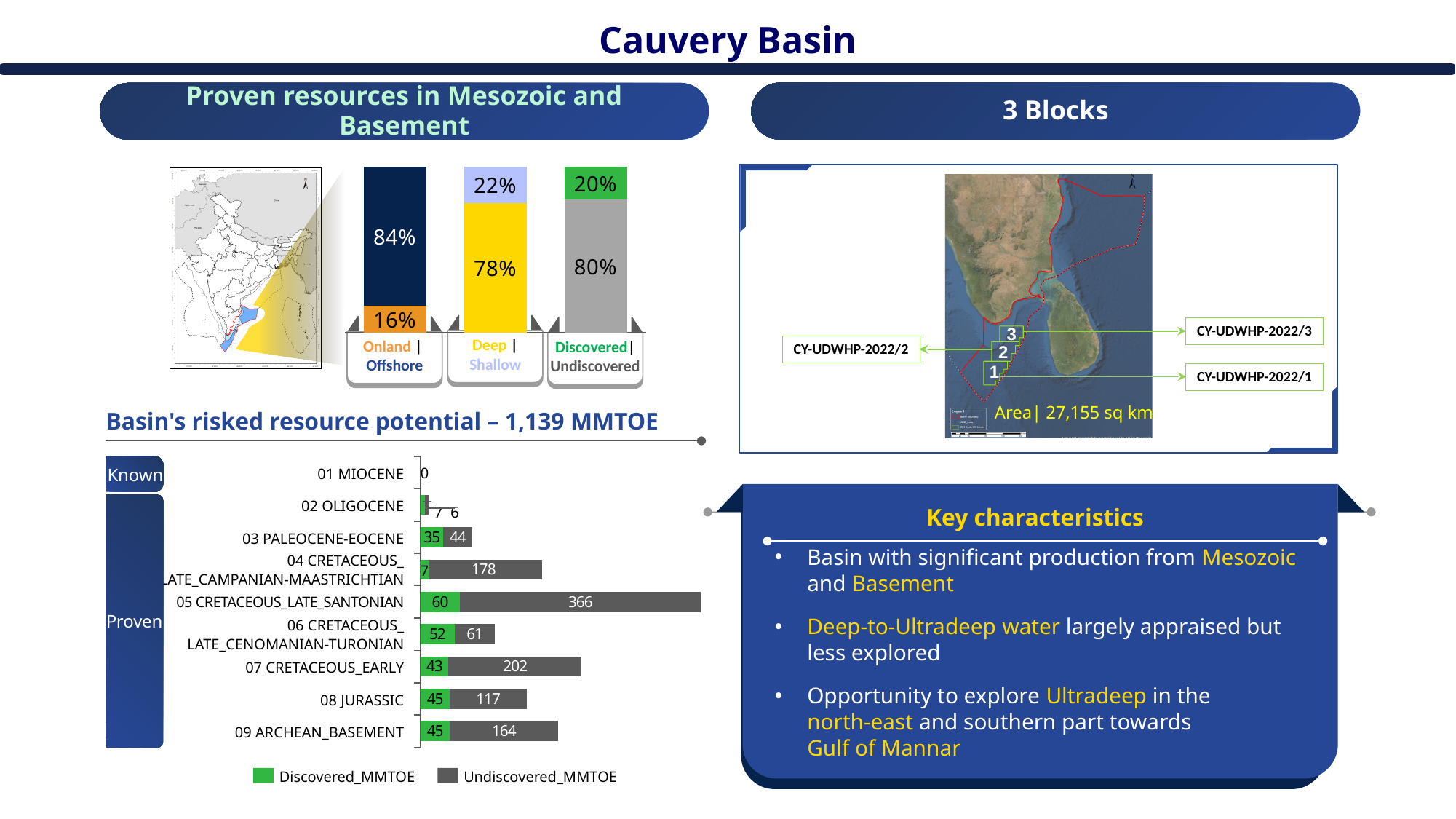
In the 'Basin's risked resource potential' chart, which category has the lowest Discovered_MMTOE value? 01 MIOCENE How many categories are shown in the 'Basin's risked resource potential' chart? 9 In the 'Basin's risked resource potential' chart, what is the total of the stacked bar for 09 ARCHEAN_BASEMENT? 209 In the 'Proven resources in Mesozoic and Basement' stacked bar chart, what percentage is Offshore? 84% In the 'Basin's risked resource potential' chart, what is the Discovered_MMTOE value for 03 PALEOCENE-EOCENE? 35 What kind of chart is the 'Basin's risked resource potential' chart? Stacked bar chart In the 'Basin's risked resource potential' chart, which is larger: the Undiscovered_MMTOE value for 04 CRETACEOUS_LATE_CAMPANIAN-MAASTRICHTIAN or for 09 ARCHEAN_BASEMENT? 04 CRETACEOUS_LATE_CAMPANIAN-MAASTRICHTIAN How many series does the legend of the 'Basin's risked resource potential' chart list? 2 In the 'Basin's risked resource potential' chart, what is the difference between the Undiscovered_MMTOE values for 07 CRETACEOUS_EARLY and 08 JURASSIC? 85 In the 'Basin's risked resource potential' chart, what is the Undiscovered_MMTOE value for 05 CRETACEOUS_LATE_SANTONIAN? 366 In the 'Basin's risked resource potential' chart, which category has the highest Undiscovered_MMTOE value? 05 CRETACEOUS_LATE_SANTONIAN In the 'Proven resources in Mesozoic and Basement' stacked bar chart, what percentage is Shallow? 22%